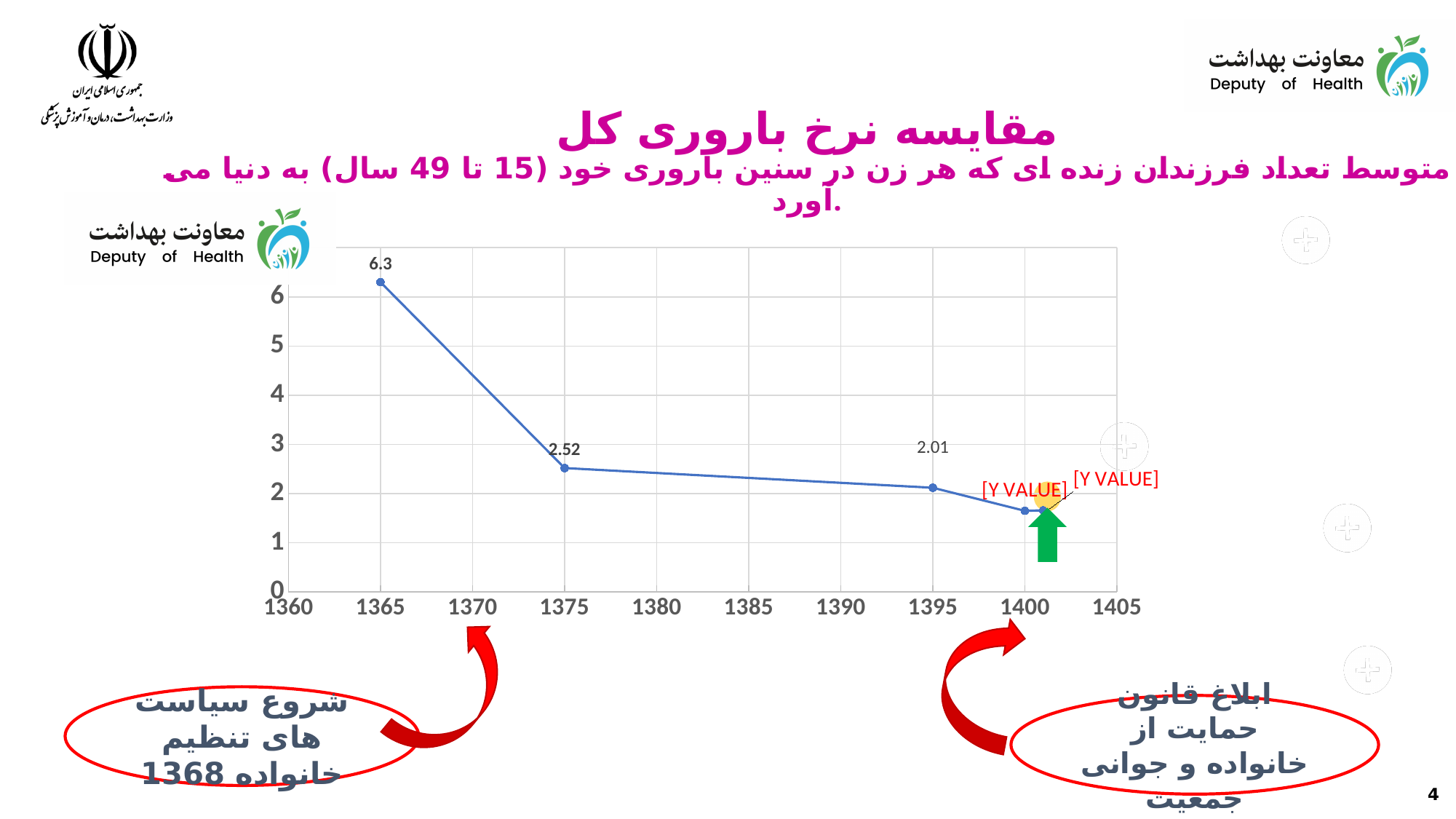
Which is larger, the value for 1375 or the value for 1395? 1375 Which year has the highest plotted value? 1365 What kind of chart is shown on the slide? line chart Do the plotted values rise or fall as the years increase along the x axis? fall What is the value plotted for the year 1365? 6.3 How many data points are plotted on the line? 5 What is the value plotted for the year 1375? 2.52 What is the difference between the values for 1375 and 1395? 0.51 What is the difference between the values for 1365 and 1375? 3.78 What is the value plotted for the year 1395? 2.01 Is the value for the year 1365 greater or less than 6? greater Is the value for the year 1400 greater or less than 2? less